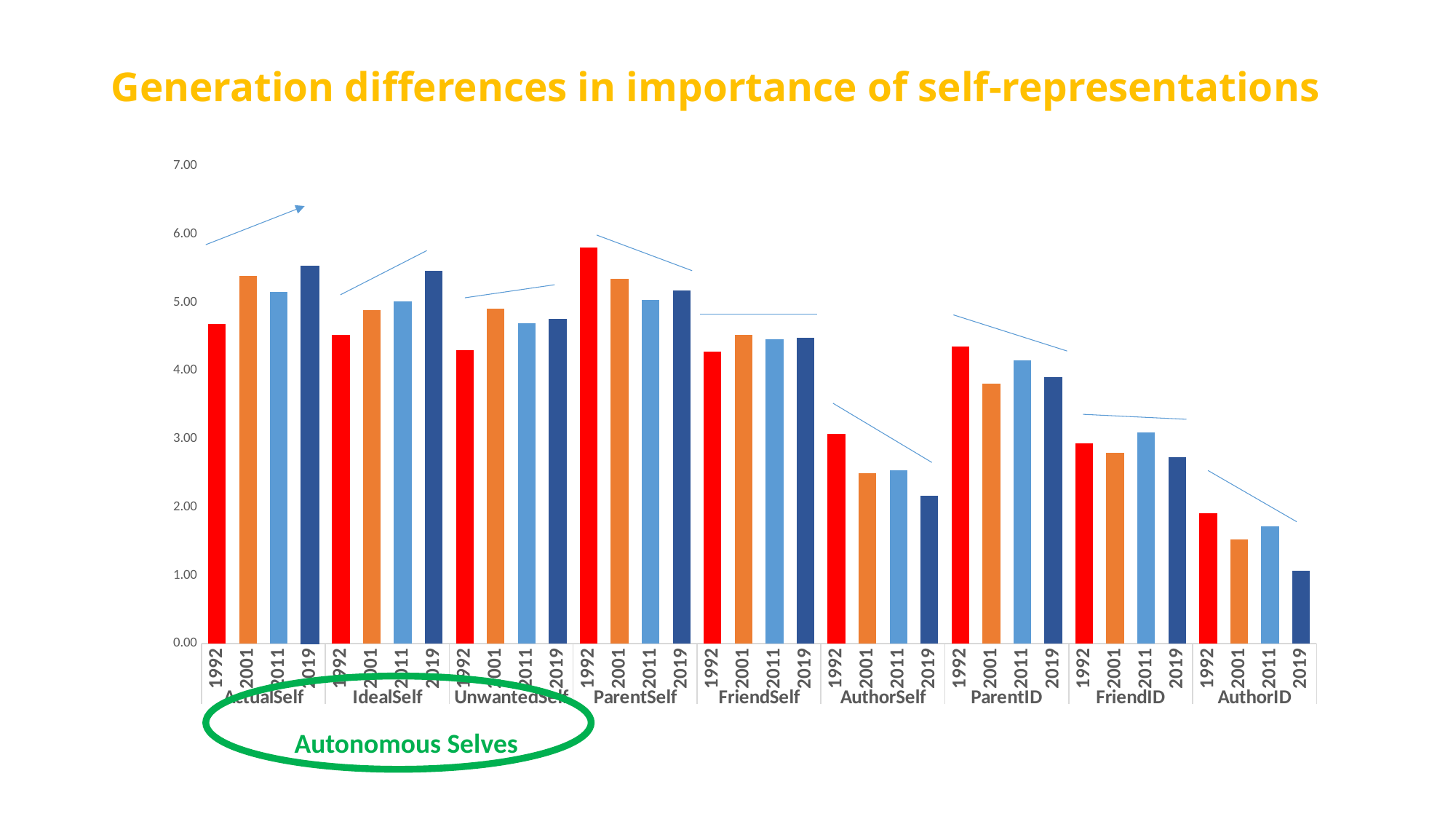
Which is larger: the value for ActualSelf in 2019 or ActualSelf in 1992? ActualSelf in 2019 What is the title of the chart? Generation differences in importance of self-representations How many self-representation categories are shown along the x axis? 9 What kind of chart is shown on the slide? bar chart Is the value for ParentSelf in 1992 greater or less than 5.00? greater How many years are plotted within each self-representation category? 4 Is the value for ActualSelf in 1992 greater or less than 4.00? greater Is the value for FriendID in 2019 greater or less than 3.00? less Do the values for AuthorID rise or fall from 1992 to 2019? fall Which bar is the highest in the whole chart? ParentSelf 1992 Which bar is the lowest in the whole chart? AuthorID 2019